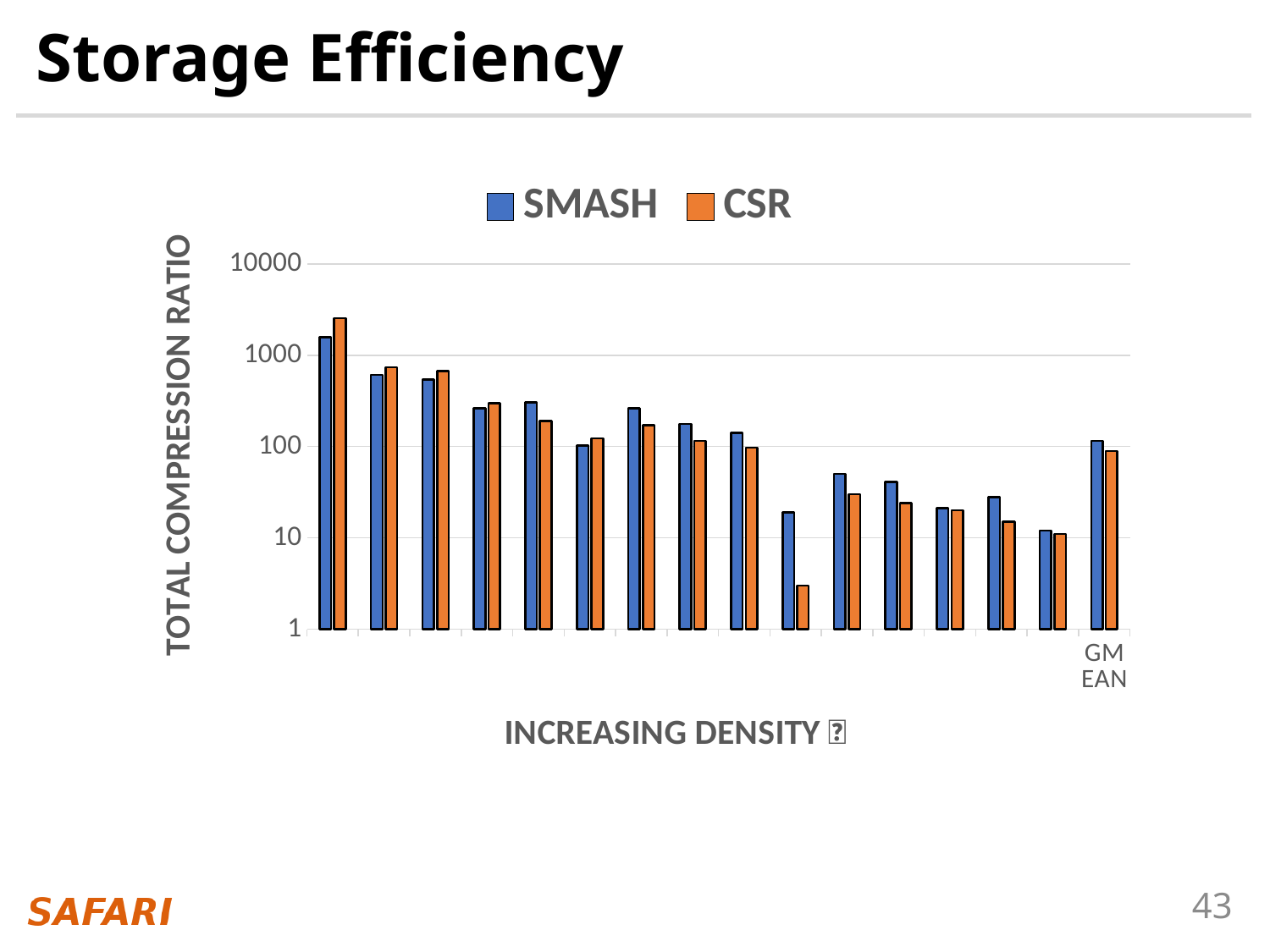
Is the SMASH value for GMEAN greater or less than 1000? less What are the two series named in the legend? SMASH and CSR Is the CSR value for GMEAN greater or less than 1000? less How many groups of bars (categories) are plotted on the x axis? 16 For the GMEAN category, which series has the larger value, SMASH or CSR? SMASH What is the label on the vertical axis? TOTAL COMPRESSION RATIO Is the CSR value for GMEAN greater or less than 10? greater How many series does the legend list? 2 Moving left to right along the x axis (excluding GMEAN), do the compression ratios generally rise or fall? fall What kind of chart is shown on the slide? bar chart